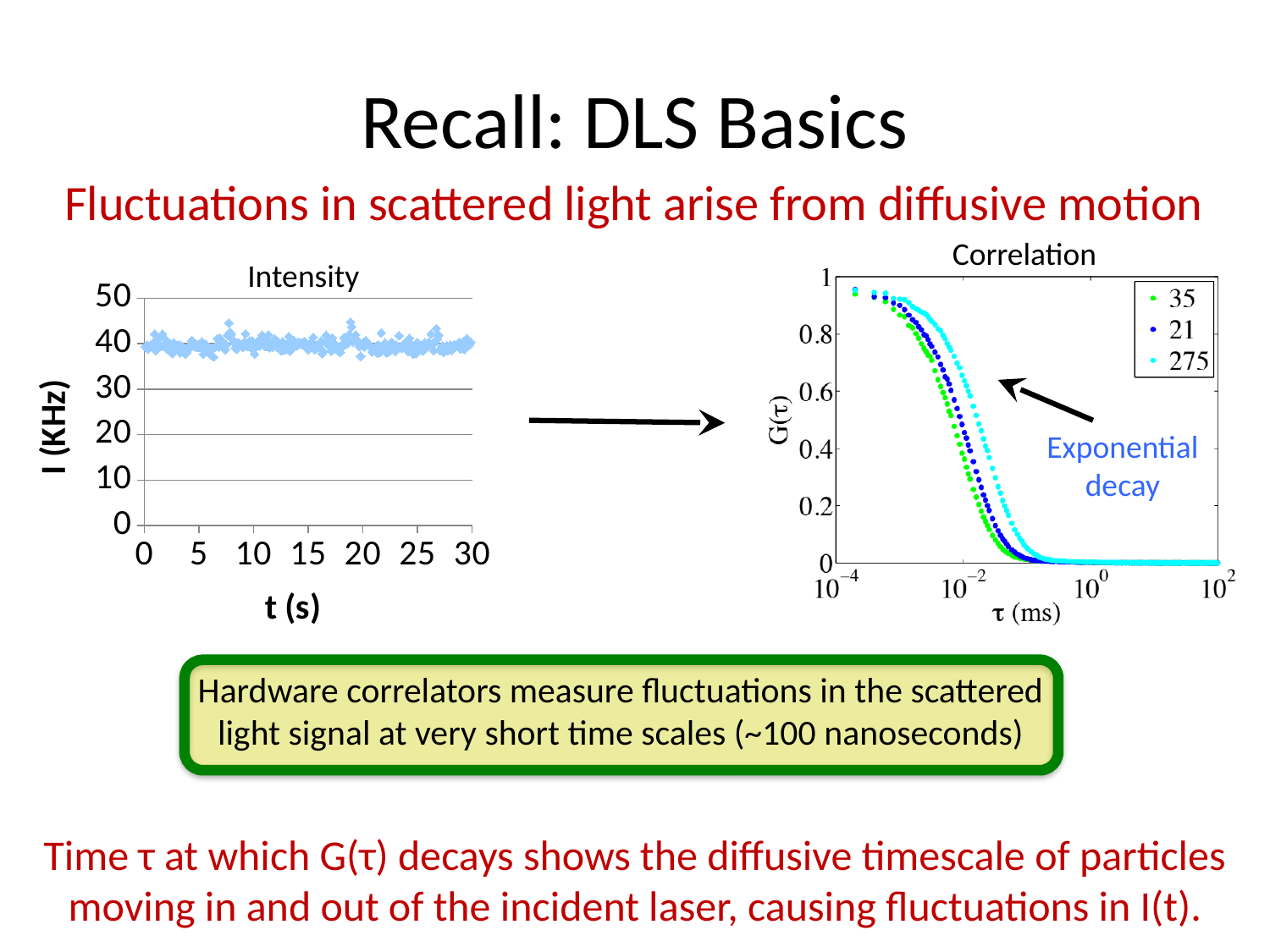
What kind of chart is the Intensity chart on the left? scatter chart On the Correlation chart, what are the entries in the legend? 35, 21, 275 On the Intensity chart, do the intensity values show a clear rising or falling trend from t = 0 to t = 30 s, or do they stay roughly flat? roughly flat On the Correlation chart, which series decays to zero first (at the smallest τ)? 35 On the Intensity chart, what is the label of the x axis? t (s) On the Correlation chart, which series reaches G(τ) = 0.5 at the largest value of τ? 275 On the Intensity chart, is the intensity value at t = 15 s greater or less than 30? greater On the Correlation chart, how many series does the legend list? 3 On the Intensity chart, is the intensity value at t = 5 s greater or less than 50? less On the Correlation chart, does G(τ) rise or fall as τ increases? fall On the Intensity chart, what is the label of the y axis? I (KHz) On the Correlation chart, is G(τ) for the 21 series at τ = 10^0 ms greater or less than 0.2? less